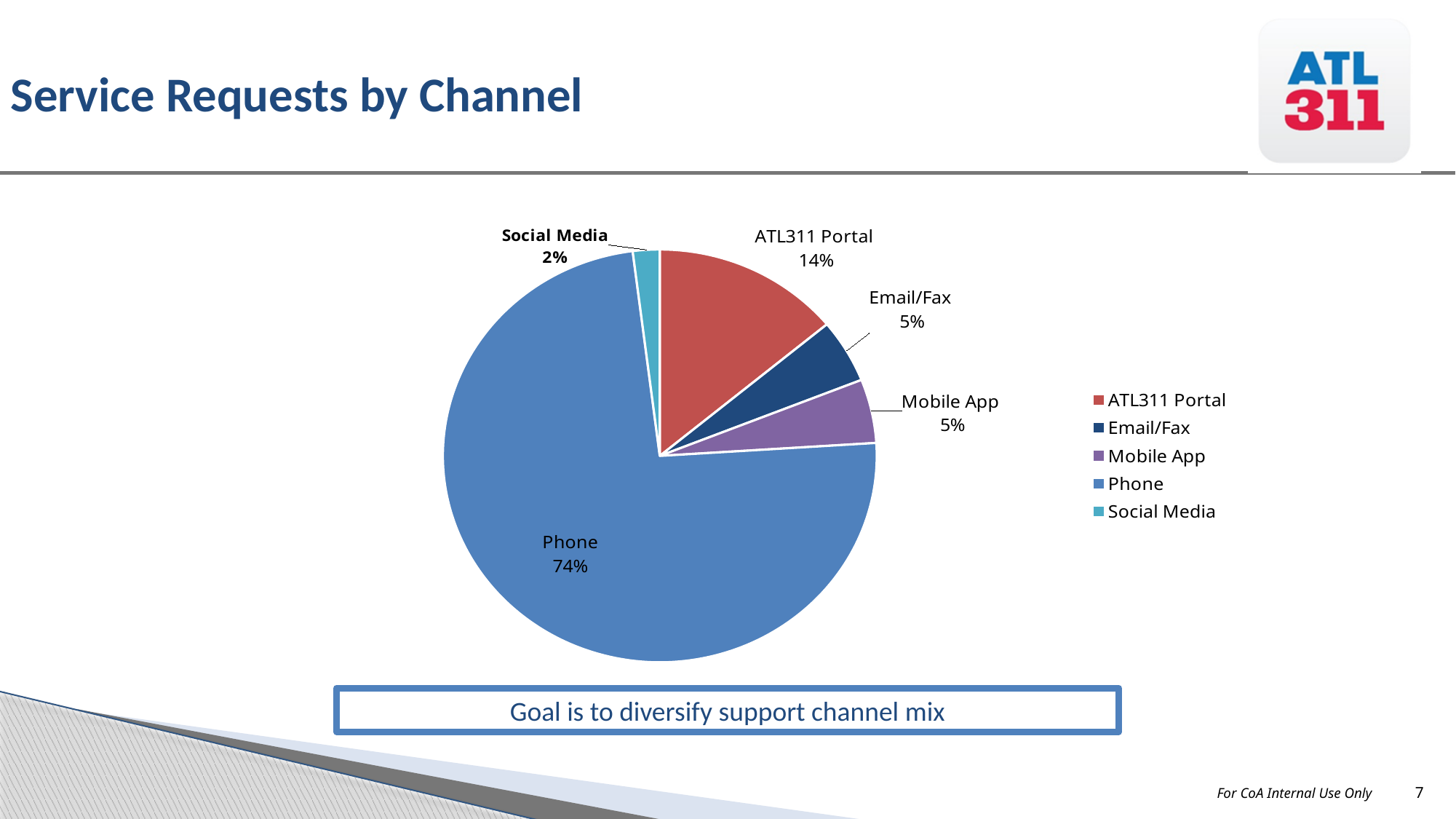
Which channel accounts for the smallest share of service requests? Social Media Which channel accounts for the largest share of service requests? Phone How many channels are shown in the pie chart? 5 What share of service requests comes through the Phone channel? 74% What type of chart is used to show service requests by channel? Pie chart Which has a larger share of service requests, ATL311 Portal or Email/Fax? ATL311 Portal What percentage of service requests comes through the Mobile App? 5% What is the combined share of Email/Fax and Mobile App? 10% What share of service requests comes via Social Media? 2% What percentage of service requests comes through the ATL311 Portal? 14% What is the difference in percentage points between the Phone share and the ATL311 Portal share? 60 What is the title of the slide containing the chart? Service Requests by Channel